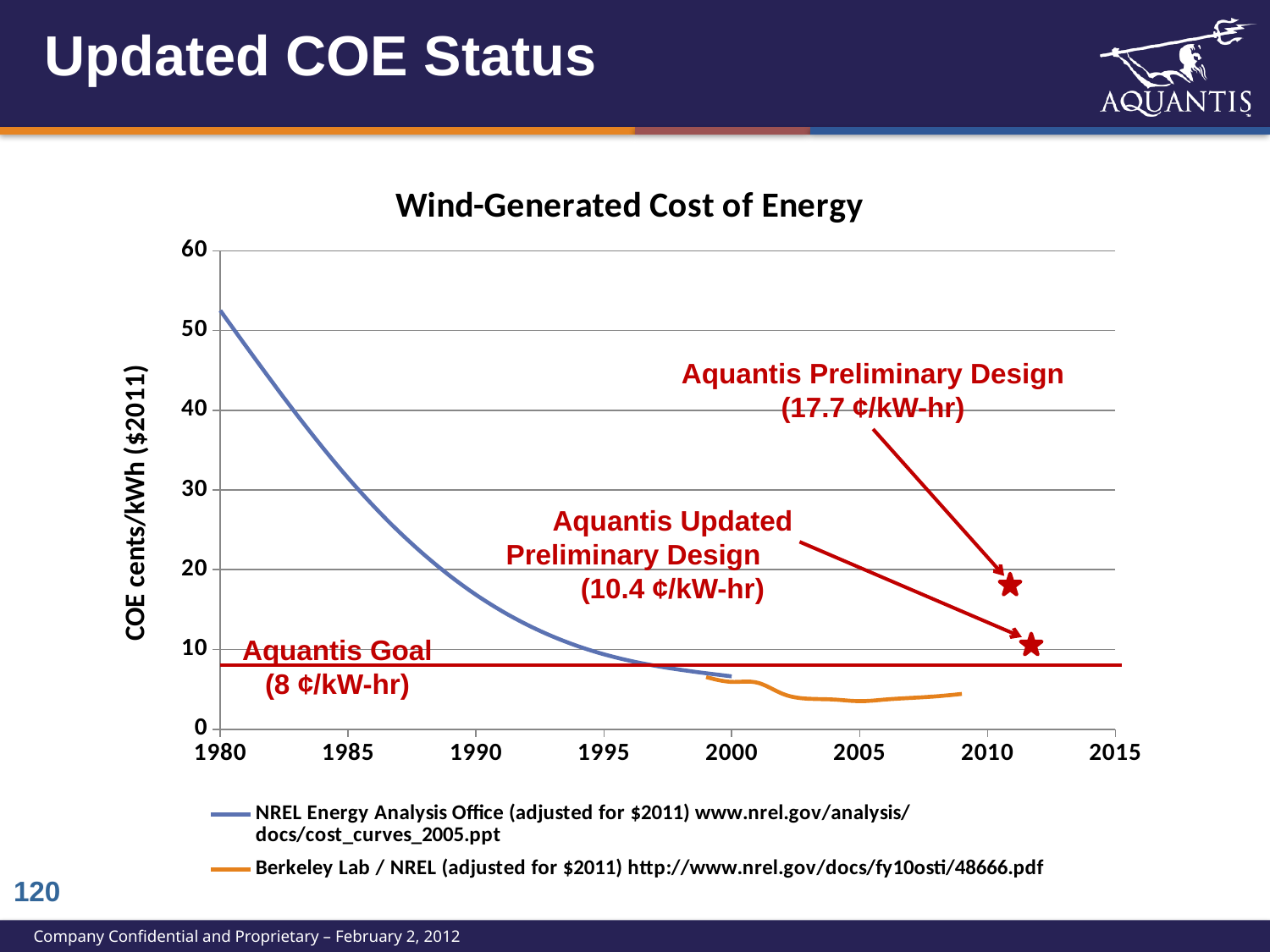
Is the NREL Energy Analysis Office value in 1980 greater or less than 50? greater What is the title of the chart? Wind-Generated Cost of Energy What is the cost of energy for the Aquantis Preliminary Design? 17.7 ¢/kW-hr Is the Berkeley Lab / NREL value in 2005 greater or less than 10? less What is the difference between the Aquantis Preliminary Design and the Aquantis Updated Preliminary Design cost of energy? 7.3 ¢/kW-hr What kind of chart is shown on the slide? Line chart Does the NREL Energy Analysis Office series rise or fall from 1980 to 2000? Fall Which is larger, the Aquantis Preliminary Design cost or the Aquantis Updated Preliminary Design cost? Aquantis Preliminary Design How much higher is the Aquantis Updated Preliminary Design cost than the Aquantis Goal? 2.4 ¢/kW-hr How many series does the chart legend list? 2 What is the Aquantis Goal cost of energy? 8 ¢/kW-hr What is the cost of energy for the Aquantis Updated Preliminary Design? 10.4 ¢/kW-hr